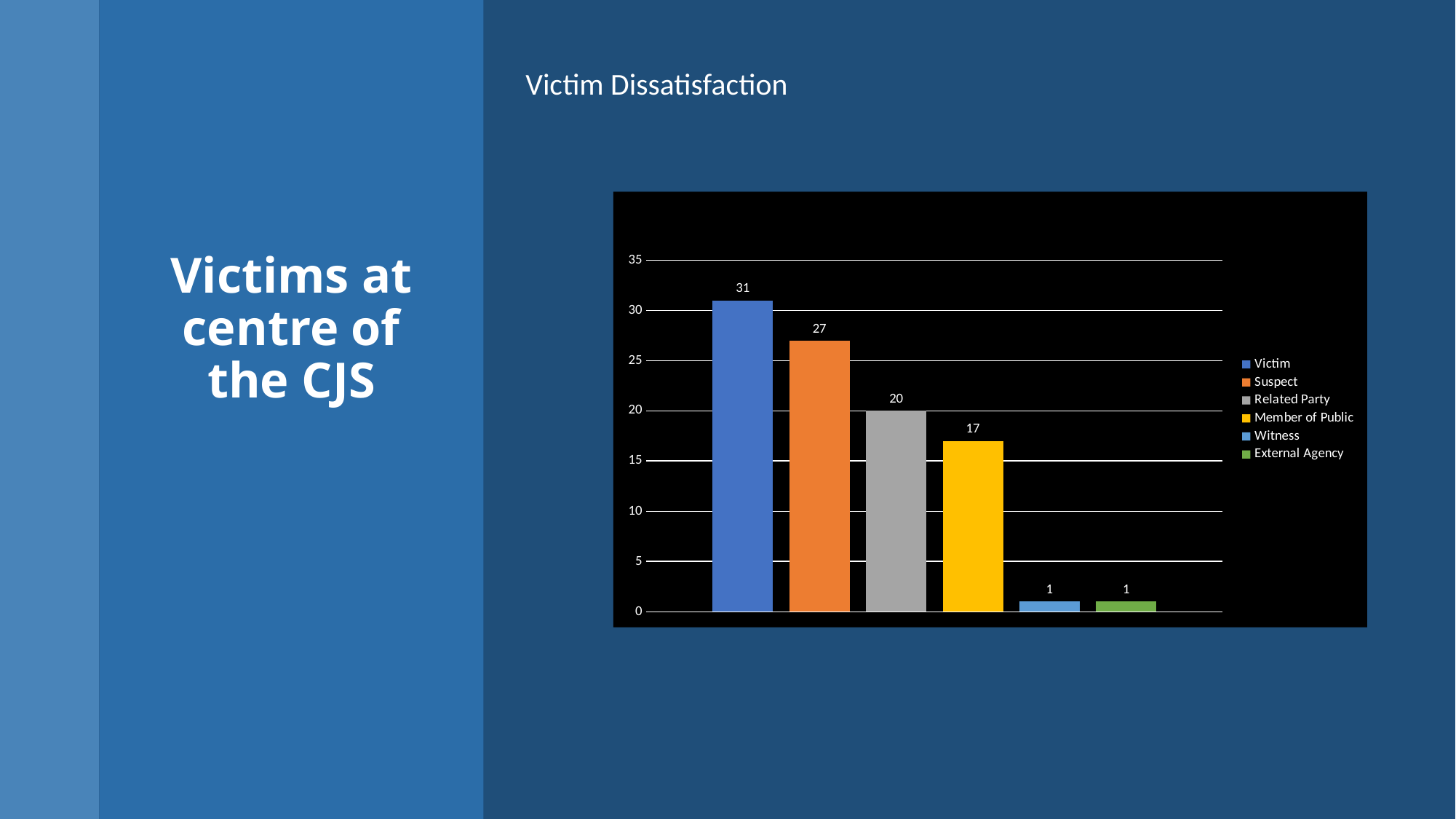
How many series does the legend list? 6 What is the difference between the values for Related Party and Member of Public? 3 What is the difference between the values for Victim and Suspect? 4 What is the value for Member of Public? 17 What is the value for Witness? 1 What is the value for Victim? 31 What is the title of the chart? Victim Dissatisfaction Which is larger, the value for Suspect or the value for Related Party? Suspect What is the value for Related Party? 20 Which category has the highest value? Victim What is the value for Suspect? 27 What kind of chart is shown on the slide? Bar chart